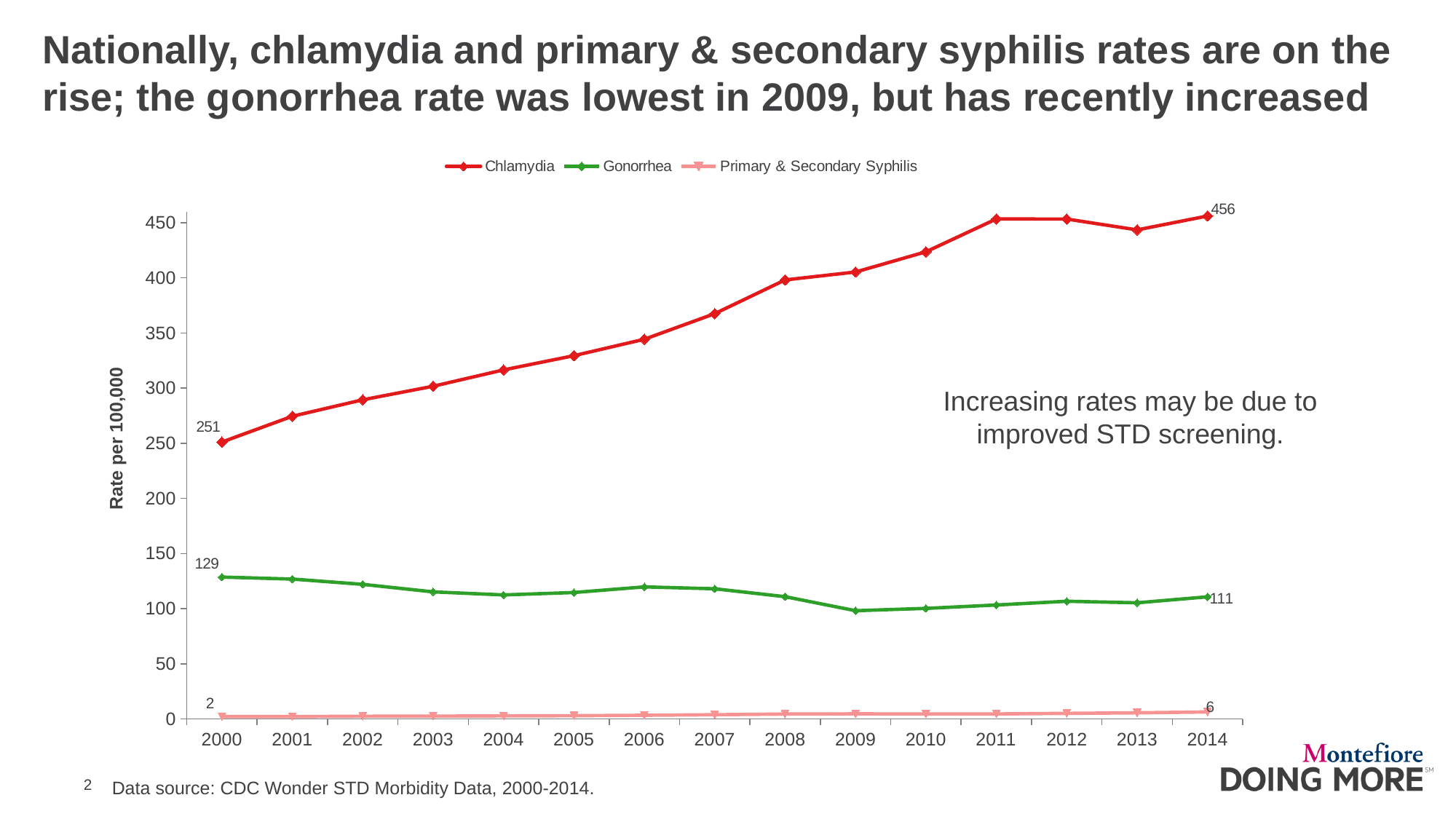
In which year was the gonorrhea rate lowest? 2009 What was the chlamydia rate per 100,000 in 2014? 456 By how much did the chlamydia rate increase from 2000 to 2014? 205 How many series does the legend list? 3 Is the chlamydia rate in 2008 greater or less than 350? greater What was the gonorrhea rate per 100,000 in 2014? 111 What type of chart is shown on the slide? line chart By how much did the gonorrhea rate decrease from 2000 to 2014? 18 Which series has the highest rate in 2014? Chlamydia What was the chlamydia rate per 100,000 in 2000? 251 What was the primary & secondary syphilis rate per 100,000 in 2014? 6 What was the gonorrhea rate per 100,000 in 2000? 129